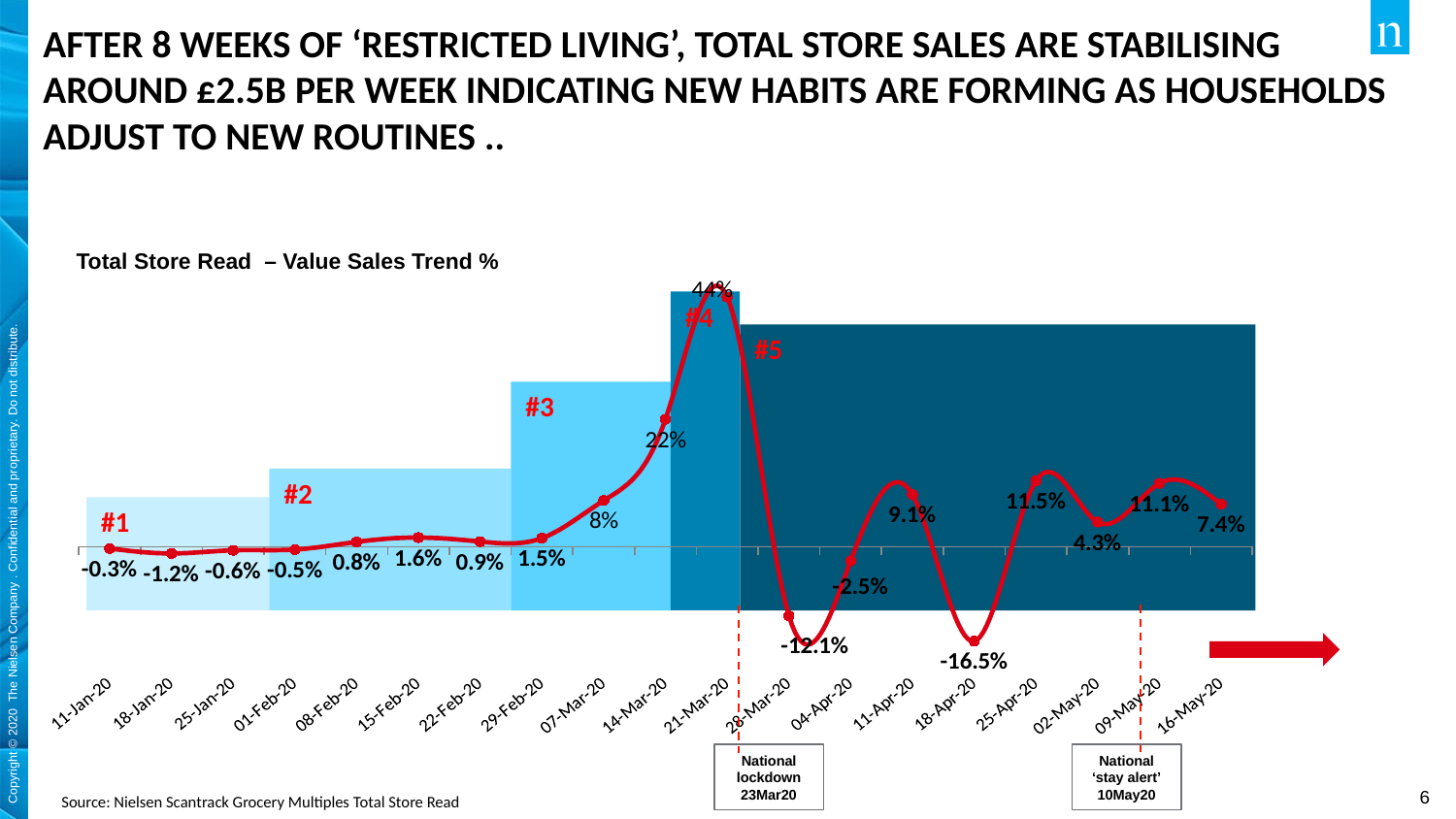
Which is larger, the value for 25-Apr-20 or the value for 09-May-20? 25-Apr-20 What kind of chart is shown on the slide? Line chart How many weekly data points are plotted on the chart? 19 What date is given for the National lockdown annotation on the chart? 23Mar20 What is the value sales trend for 14-Mar-20? 22% Which week has the highest value sales trend? 21-Mar-20 What is the title of the chart? Total Store Read – Value Sales Trend % Which week has the lowest value sales trend? 18-Apr-20 What is the value sales trend for 21-Mar-20? 44% What is the value sales trend for 18-Apr-20? -16.5% What is the value sales trend for 16-May-20? 7.4% What is the difference between the values for 21-Mar-20 and 14-Mar-20? 22 percentage points